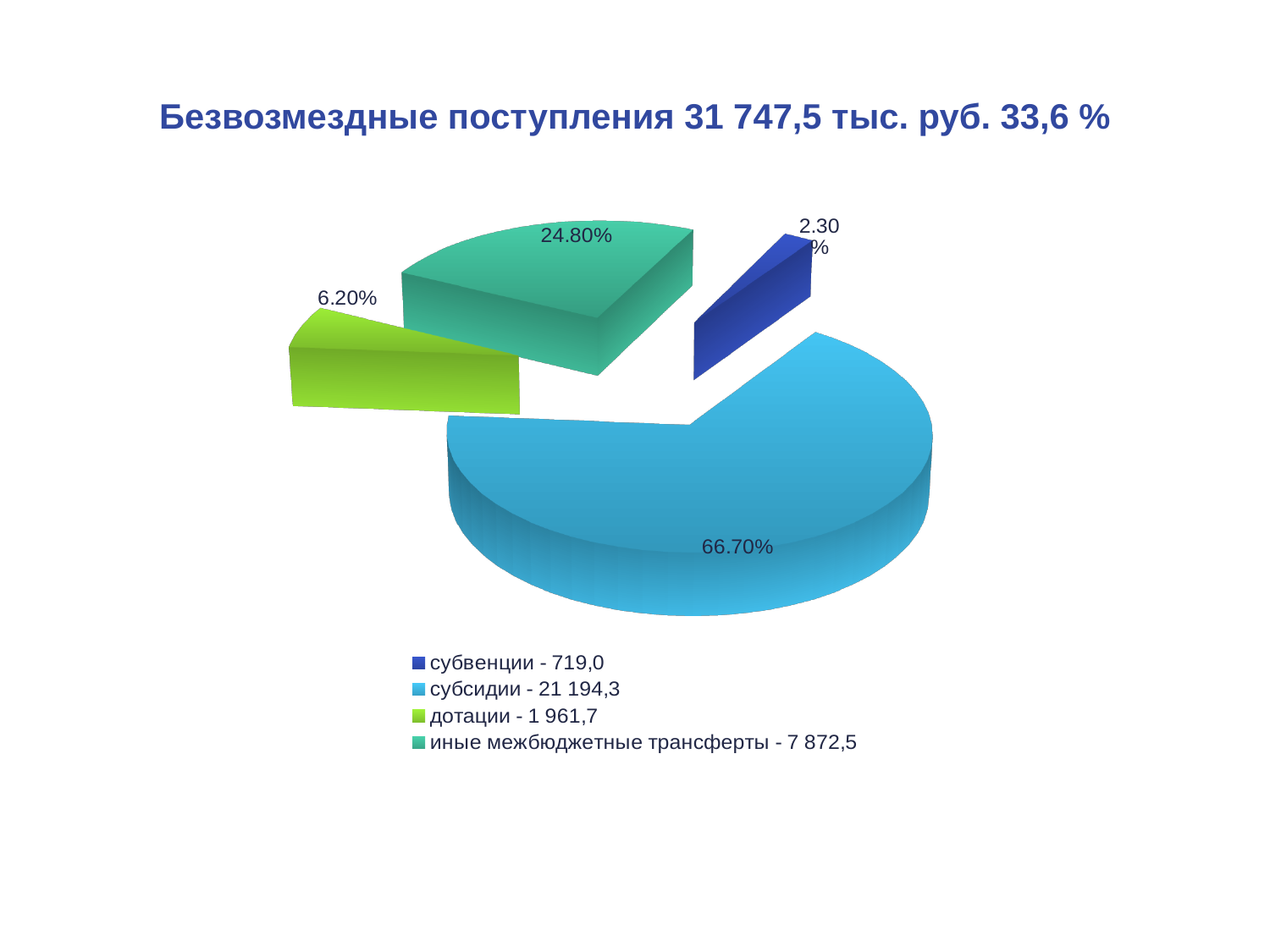
Which is larger, the share for дотации or the share for субвенции? дотации What percentage share is shown for the иные межбюджетные трансферты slice? 24.80% Which category has the largest share of the pie? субсидии How many slices does the pie chart have? 4 What percentage share is shown for the субсидии slice? 66.70% What kind of chart is shown on the slide? pie chart What value is listed in the legend for субсидии? 21 194,3 What percentage share is shown for the субвенции slice? 2.30% What value is listed in the legend for иные межбюджетные трансферты? 7 872,5 What is the title of the chart? Безвозмездные поступления 31 747,5 тыс. руб. 33,6 % Which category has the smallest share of the pie? субвенции